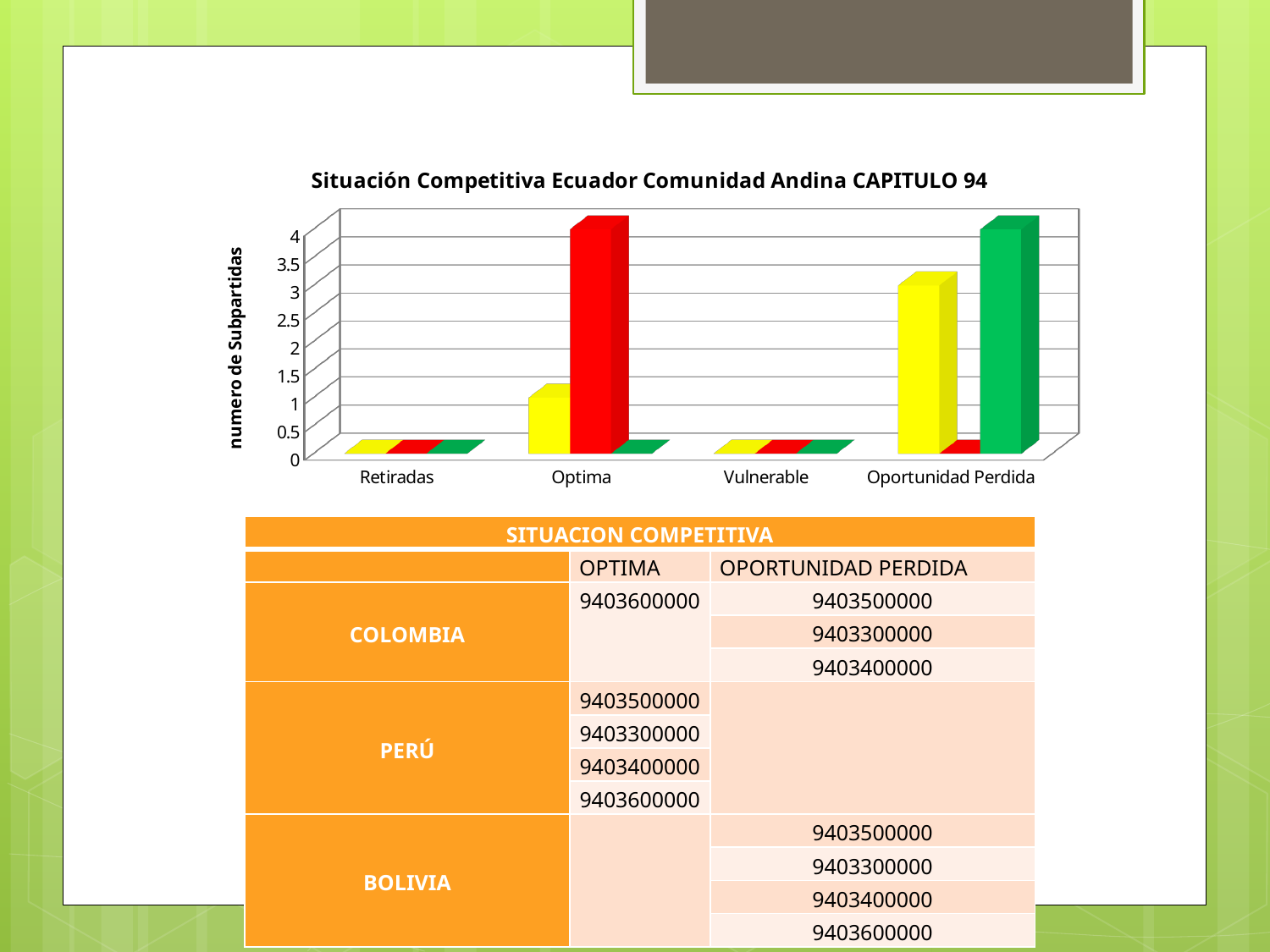
Is the value of the red bar for Oportunidad Perdida greater or less than 1? less In the Optima category, which bar is taller, the red bar or the yellow bar? the red bar What is the title of the chart? Situación Competitiva Ecuador Comunidad Andina CAPITULO 94 Is the value of the yellow bar for Optima greater or less than 2? less How many categories are shown on the x axis of the chart? 4 What type of chart is shown on the slide? bar chart In the Oportunidad Perdida category, which bar is taller, the green bar or the yellow bar? the green bar Is the value of the green bar for Oportunidad Perdida greater or less than 3? greater What is the label of the vertical axis of the chart? numero de Subpartidas